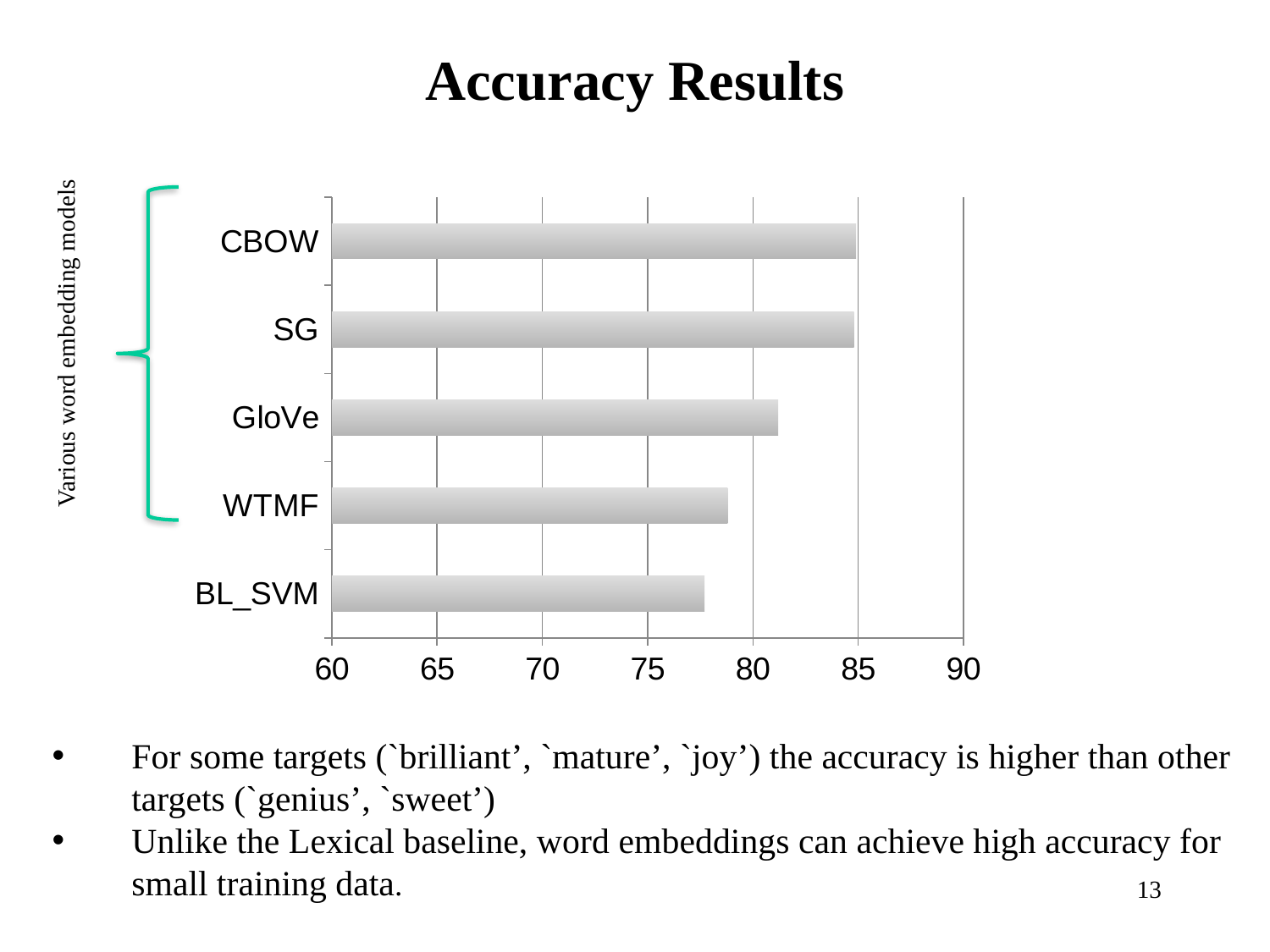
How many categories (models) are plotted in the chart? 5 What kind of chart is shown on the slide? bar chart What is the title of the chart on the slide? Accuracy Results Is the value for CBOW greater or less than 80? greater Which is larger, the value for SG or the value for BL_SVM? SG Is the value for GloVe greater or less than 80? greater Which category has the lowest value in the chart? BL_SVM Which is larger, the value for GloVe or the value for WTMF? GloVe Which is larger, the value for CBOW or the value for GloVe? CBOW Is the value for GloVe greater or less than 85? less